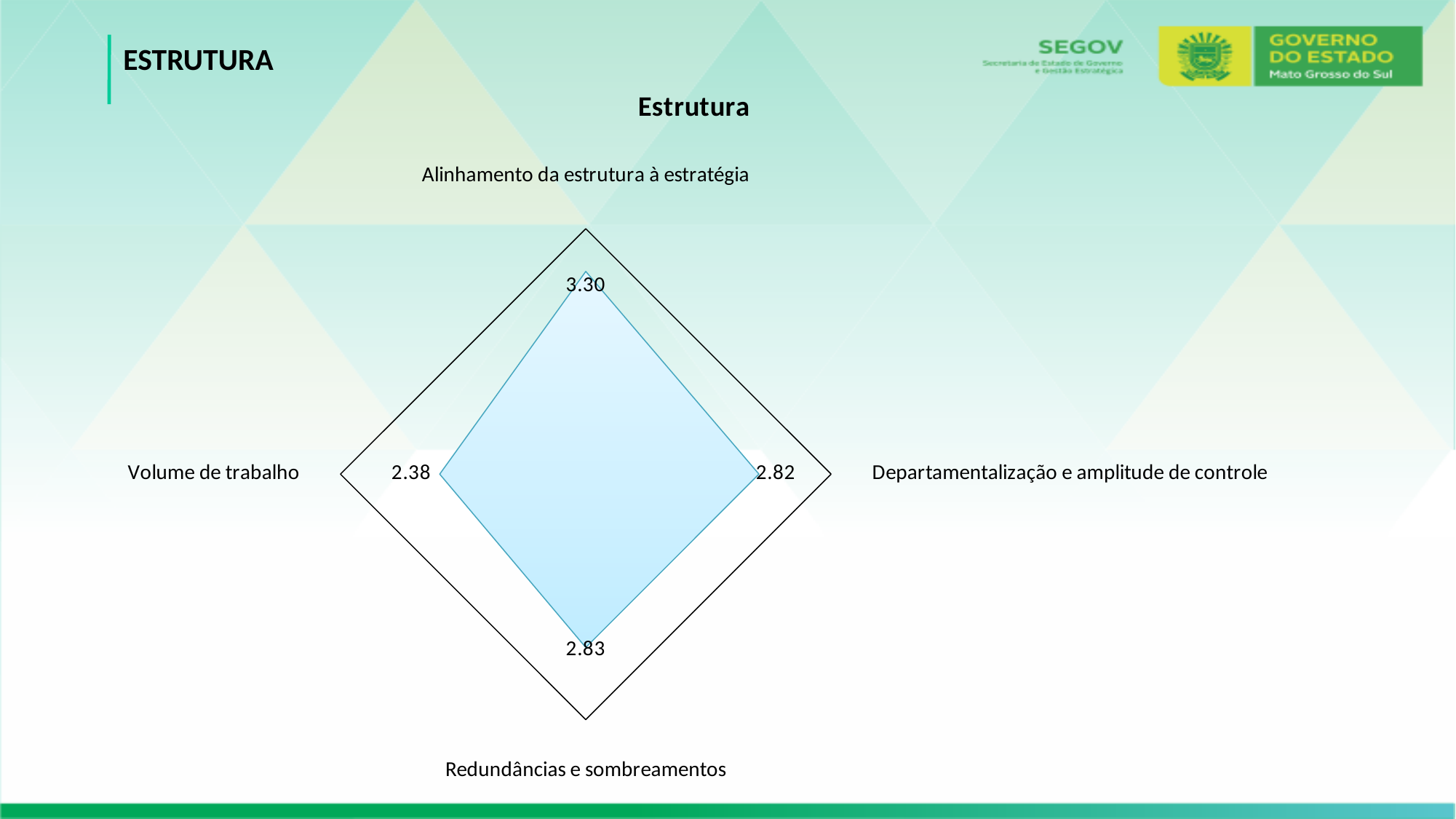
What is the value for Redundâncias e sombreamentos? 2.83 What is the value for Alinhamento da estrutura à estratégia? 3.30 What is the value for Volume de trabalho? 2.38 What is the title of the chart? Estrutura Which category has the lowest value? Volume de trabalho Which is larger: the value for Alinhamento da estrutura à estratégia or the value for Departamentalização e amplitude de controle? Alinhamento da estrutura à estratégia What is the difference between the values for Redundâncias e sombreamentos and Volume de trabalho? 0.45 What is the difference between the values for Alinhamento da estrutura à estratégia and Volume de trabalho? 0.92 Which category has the highest value? Alinhamento da estrutura à estratégia How many categories (axes) does the radar chart have? 4 What is the value for Departamentalização e amplitude de controle? 2.82 What type of chart is shown on the slide? Radar chart